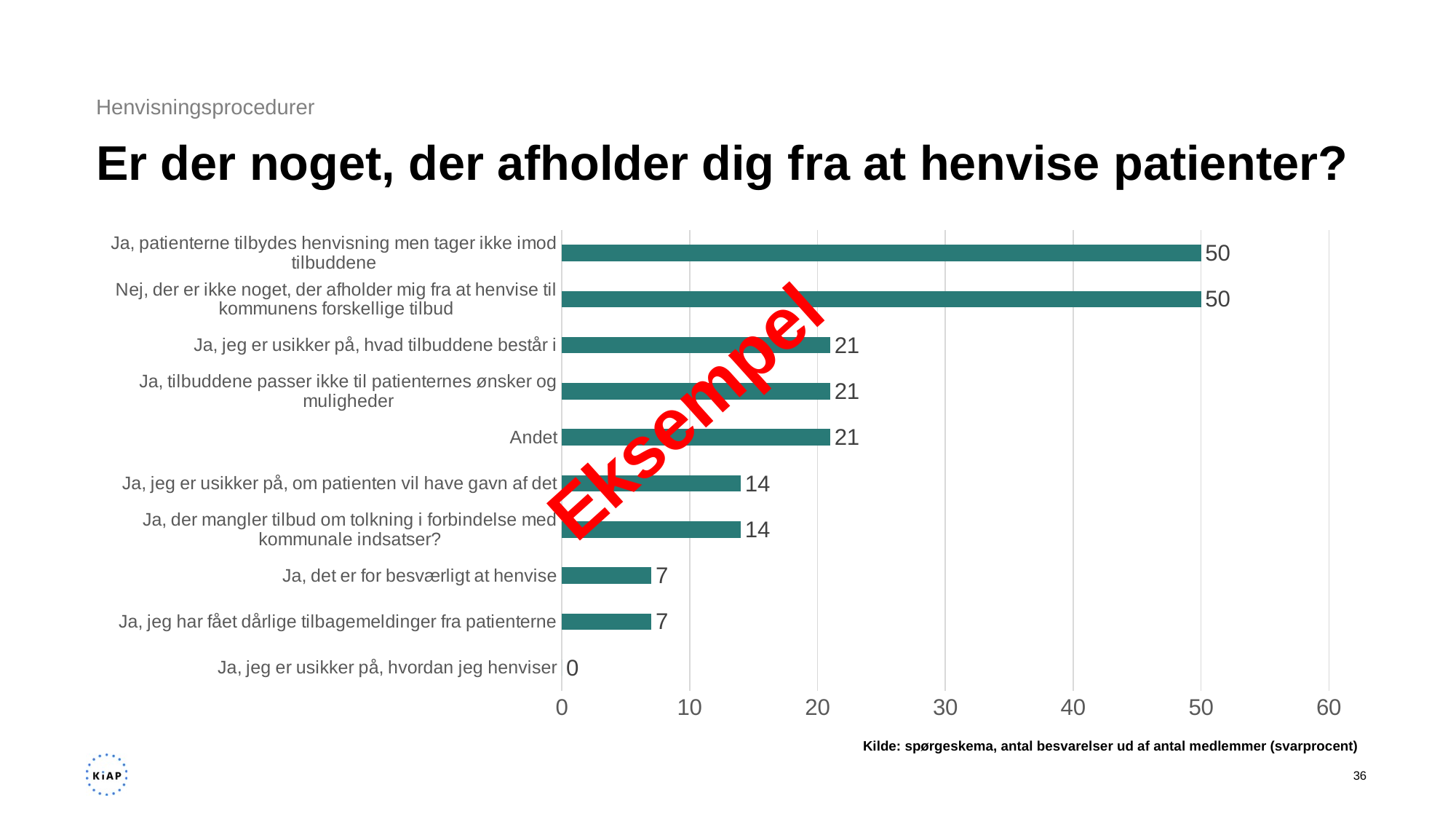
What is the title of the slide? Er der noget, der afholder dig fra at henvise patienter? What is the value for "Ja, det er for besværligt at henvise"? 7 Which is larger: the value for "Andet" or the value for "Ja, der mangler tilbud om tolkning i forbindelse med kommunale indsatser?"? Andet What is the value for "Andet"? 21 Which category has the lowest value? Ja, jeg er usikker på, hvordan jeg henviser What kind of chart is shown on the slide? bar chart What is the value for "Ja, patienterne tilbydes henvisning men tager ikke imod tilbuddene"? 50 What is the difference between the value for "Ja, tilbuddene passer ikke til patienternes ønsker og muligheder" and the value for "Ja, jeg har fået dårlige tilbagemeldinger fra patienterne"? 14 How many categories are shown in the chart? 10 What is the difference between the value for "Nej, der er ikke noget, der afholder mig fra at henvise til kommunens forskellige tilbud" and the value for "Ja, jeg er usikker på, hvad tilbuddene består i"? 29 Is the value for "Ja, jeg er usikker på, hvad tilbuddene består i" greater or less than 30? less What is the value for "Ja, jeg er usikker på, om patienten vil have gavn af det"? 14